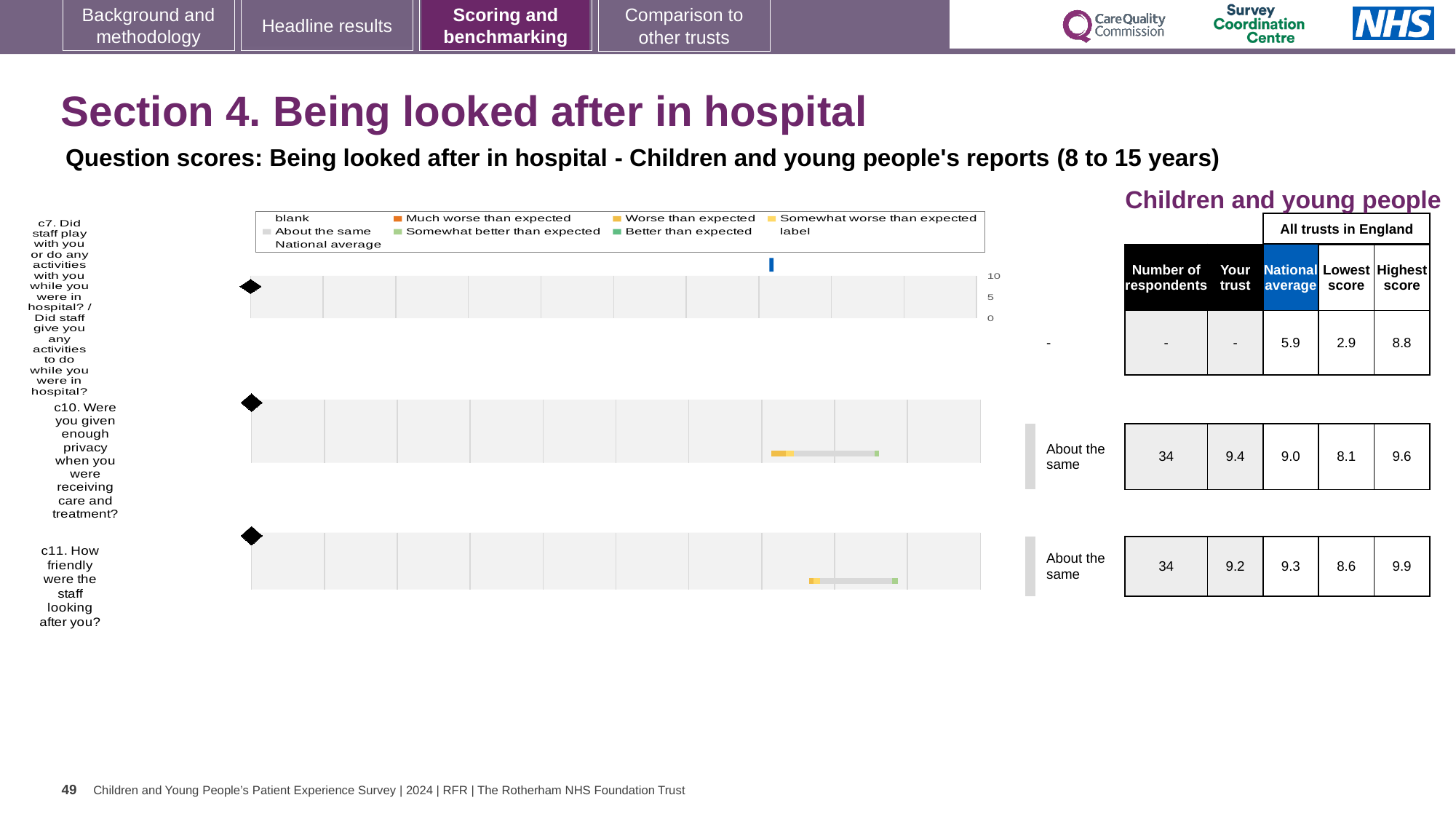
Which question has the lowest national average score? c7 What is the difference between the trust's score and the national average for question c10? 0.4 How many questions are plotted on the chart? 3 What benchmark category is shown for question c10? About the same What is the 'Your trust' score for question c11 (How friendly were the staff looking after you?)? 9.2 What is the 'Your trust' score for question c10 (Were you given enough privacy when you were receiving care and treatment?)? 9.4 What is the difference between the highest and lowest scores across all trusts for question c7? 5.9 What is the highest score across all trusts in England for question c11? 9.9 How many respondents answered question c10? 34 For question c11, which is larger: the trust's score or the national average? National average What is the lowest score across all trusts in England for question c10? 8.1 What is the national average score for question c7 (Did staff play with you or do any activities with you while you were in hospital?)? 5.9